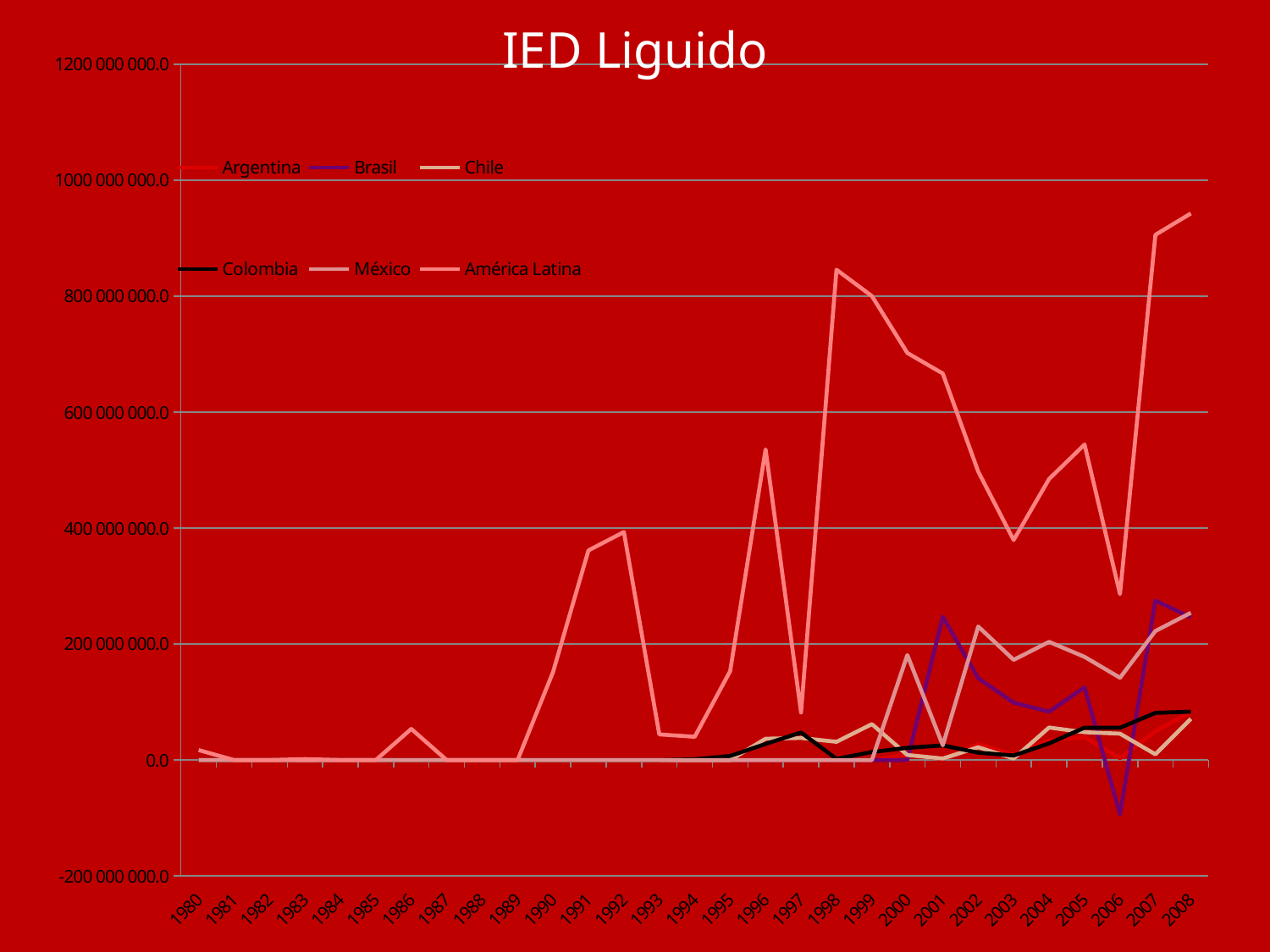
Is the value for Brasil in 2007 greater or less than 200 000 000.0? greater Which series has the highest value in 2008? América Latina What is the title of the chart? IED Liquido What kind of chart is shown on the slide? line chart Does the América Latina line rise or fall from 2006 to 2008? rise Is the value for Brasil in 2006 greater or less than 0.0? less Is the value for América Latina in 1997 greater or less than 200 000 000.0? less Which is larger in 2001, the value for Brasil or the value for Colombia? Brasil How many years are plotted along the x axis? 29 Which series has the lowest value in 2006? Brasil How many series does the legend list? 6